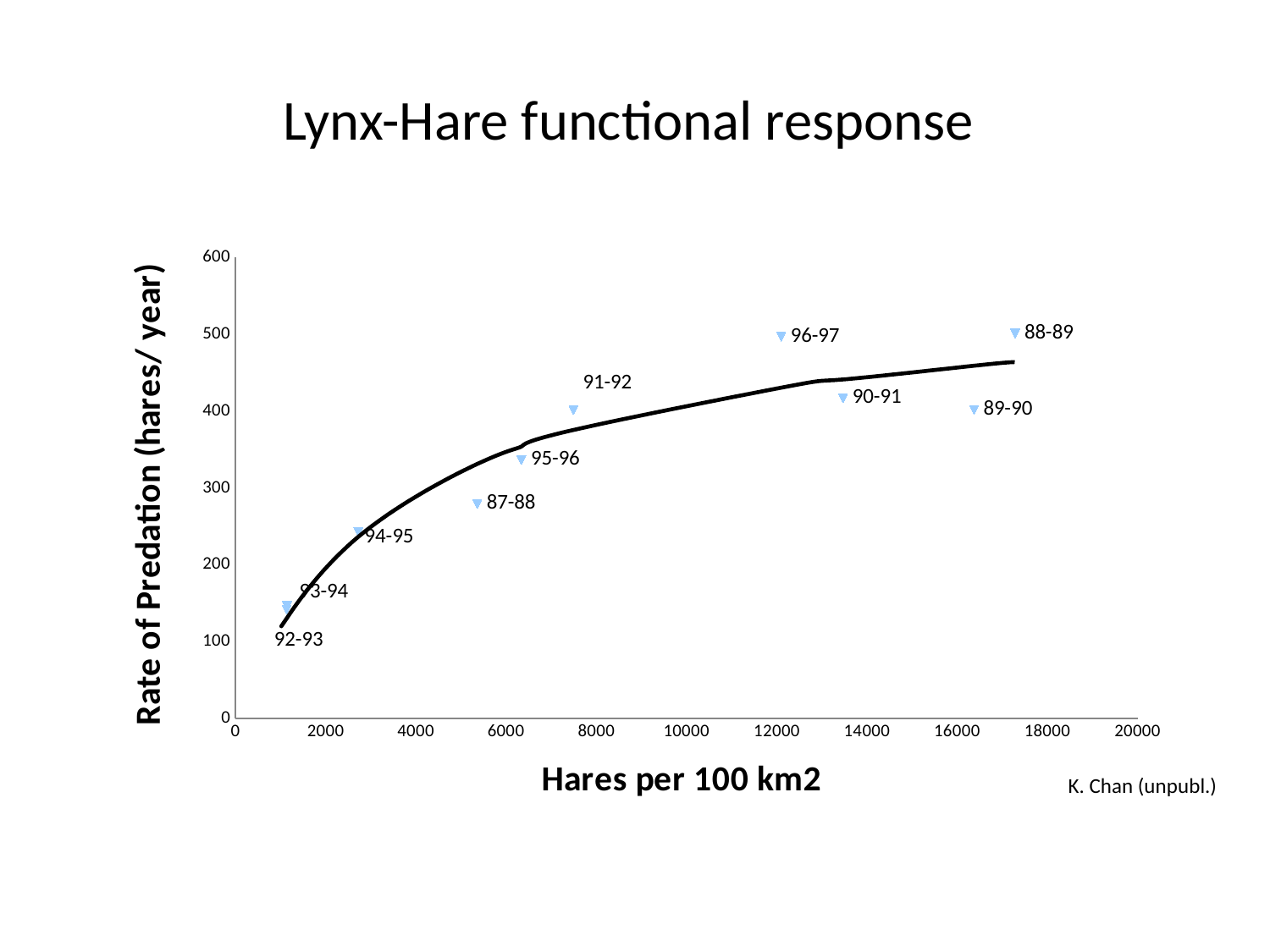
Which has a higher rate of predation, 96-97 or 90-91? 96-97 How many labelled data points are plotted on the chart? 10 Is the rate of predation for 88-89 greater or less than 400? greater Is the rate of predation for 89-90 greater or less than 500? less Does the fitted curve rise or fall as hares per 100 km2 increases? rise Is the rate of predation for 96-97 greater or less than 400? greater Which has a higher rate of predation, 87-88 or 95-96? 95-96 What is the title of the chart? Lynx-Hare functional response What is the label of the x axis? Hares per 100 km2 What kind of chart is shown on the slide? scatter chart